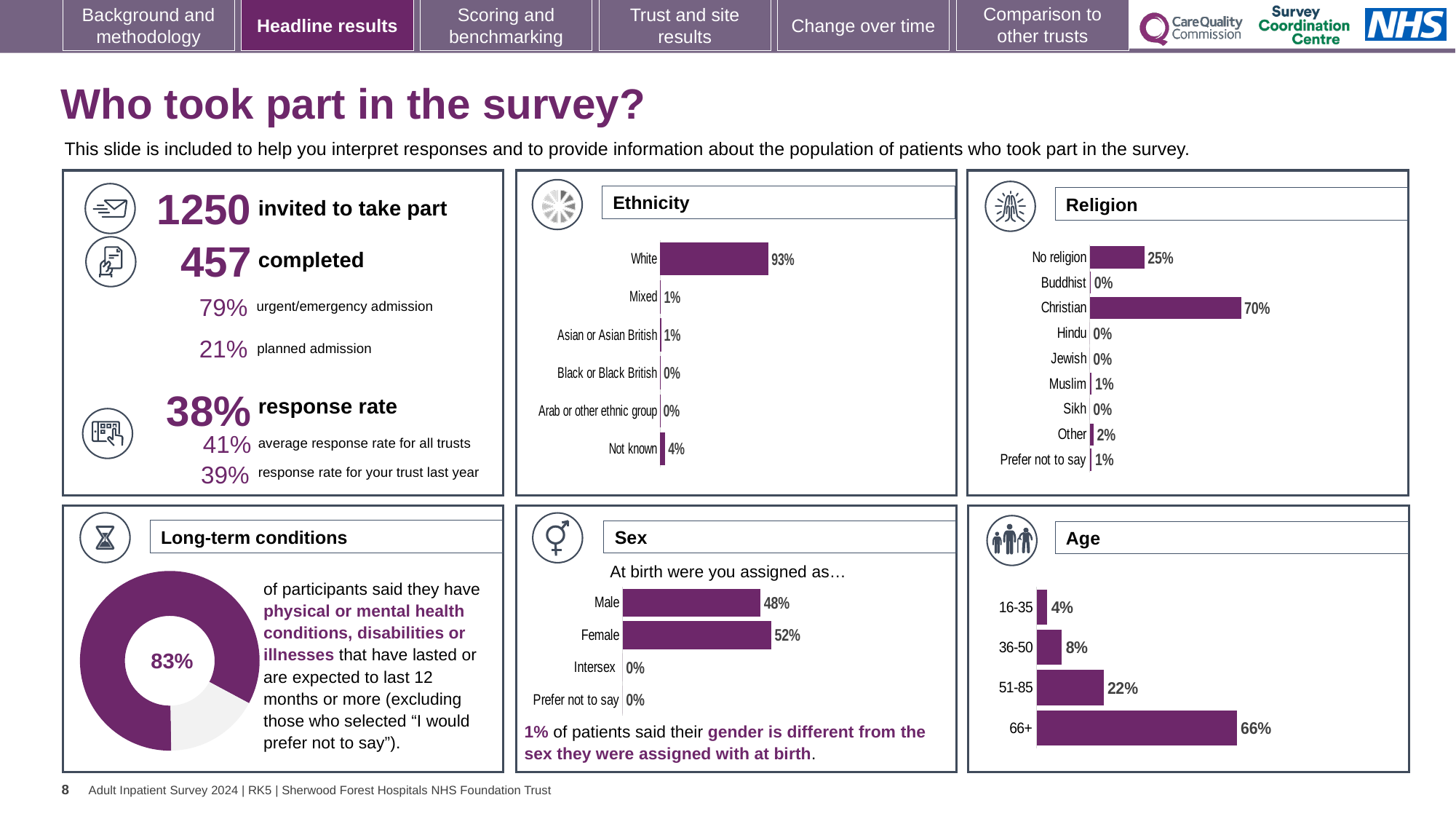
In the Religion chart, what is the difference between Christian and No religion? 45% What kind of chart is the Age chart? Bar chart In the Religion chart, what is the value for No religion? 25% In the Sex chart, what is the value for Male? 48% In the Sex chart, which is larger, Male or Female? Female In the Ethnicity chart, what percentage of respondents are White? 93% In the Ethnicity chart, what percentage of respondents are Not known? 4% In the Age chart, which age group has the highest value? 66+ In the Religion chart, which religion category has the highest value? Christian In the Ethnicity chart, how many ethnicity categories are shown? 6 In the Age chart, what is the difference between the 66+ and 51-85 groups? 44% In the Religion chart, how many religion categories are shown? 9